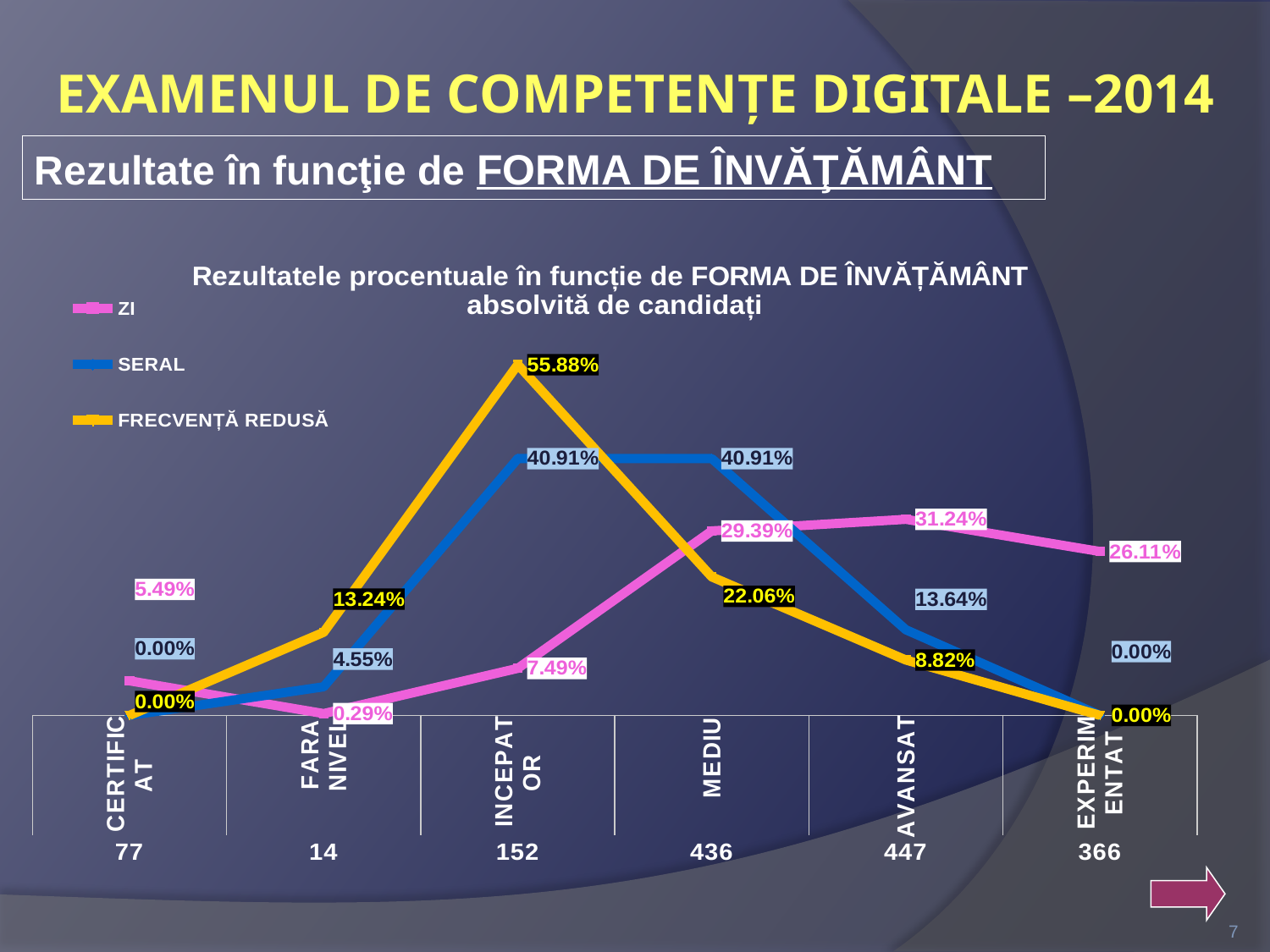
What is the difference between the FRECVENȚĂ REDUSĂ value and the SERAL value for the INCEPATOR category? 14.97% In which category does the ZI series reach its highest value? AVANSAT How many series does the chart legend list? 3 Does the FRECVENȚĂ REDUSĂ series rise or fall from INCEPATOR to EXPERIMENTAT? Fall What type of chart is shown on the slide? Line chart What is the value of the FRECVENȚĂ REDUSĂ series for the INCEPATOR category? 55.88% What is the value of the SERAL series for the AVANSAT category? 13.64% How many categories are shown on the x axis of the chart? 6 What is the value of the ZI series for the AVANSAT category? 31.24% For the MEDIU category, which series has the larger value, SERAL or ZI? SERAL What is the value of the ZI series for the FARA NIVEL category? 0.29% In which category does the FRECVENȚĂ REDUSĂ series reach its highest value? INCEPATOR